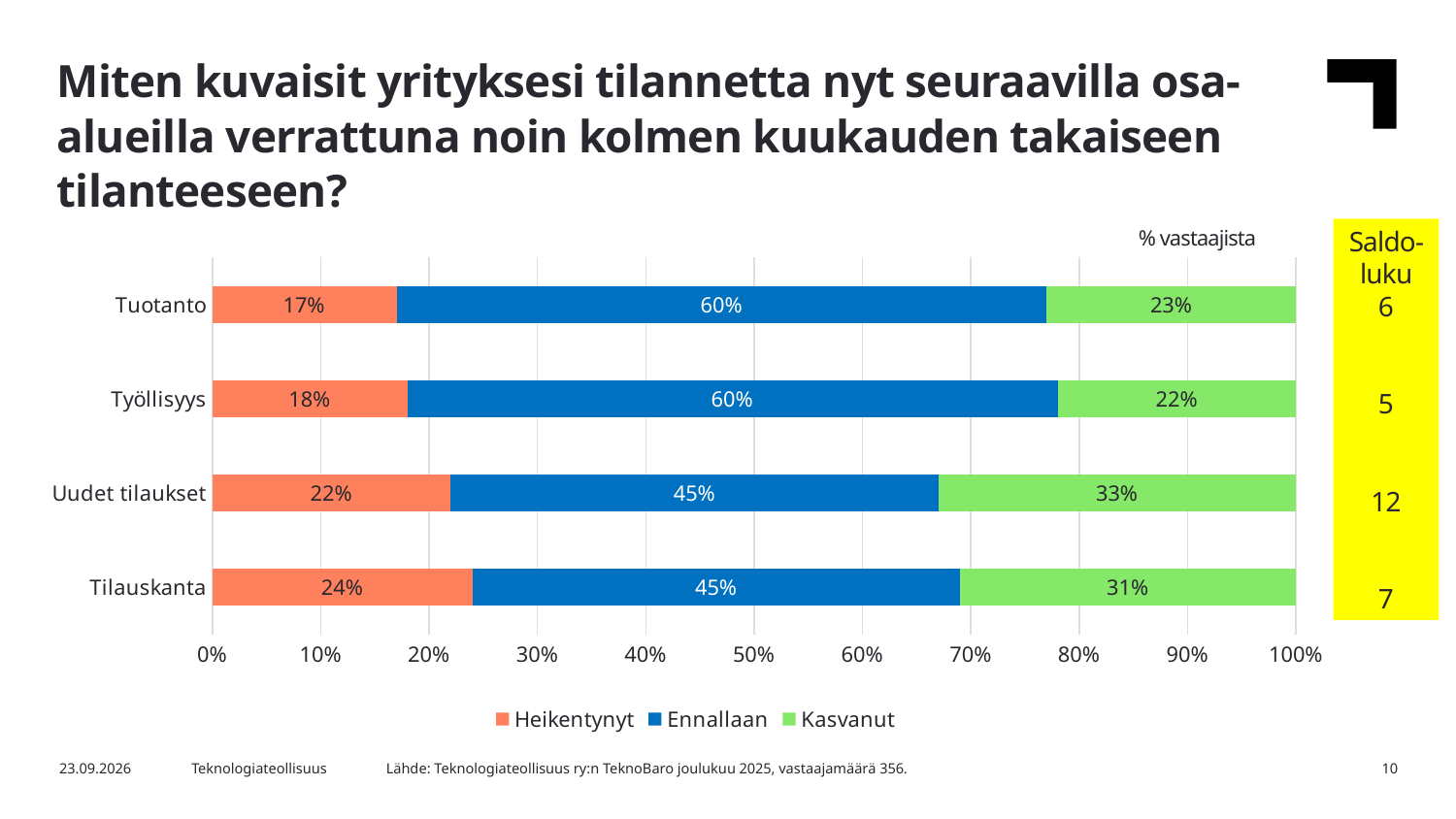
What is the value for Heikentynyt in the Tuotanto category? 17% What is the Saldoluku value shown for Uudet tilaukset? 12 Which category has the highest Heikentynyt value? Tilauskanta How many series does the legend list? 3 Which category has the lowest Kasvanut value? Työllisyys What is the value for Ennallaan in the Tilauskanta category? 45% What is the difference between the Kasvanut values for Uudet tilaukset and Tuotanto? 10% What kind of chart is shown on the slide? Stacked bar chart What is the value for Kasvanut in the Uudet tilaukset category? 33% What is the total of the stacked bar for Tilauskanta? 100% How many categories are shown on the y axis of the chart? 4 Which is larger: the Ennallaan value for Työllisyys or the Ennallaan value for Uudet tilaukset? Työllisyys